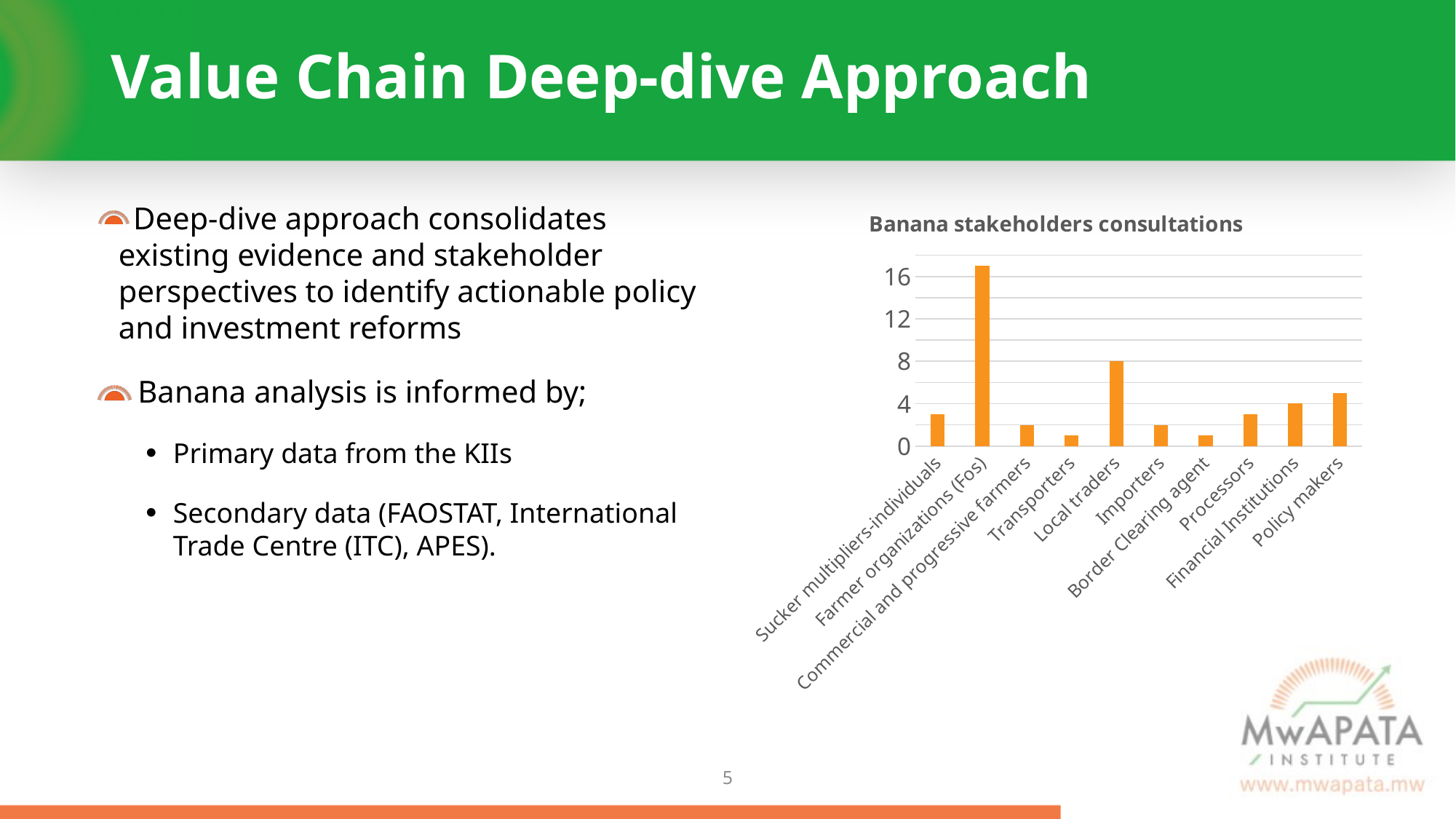
Is the value for Policy makers greater or less than 4? greater Which is larger, the value for Farmer organizations (Fos) or the value for Local traders? Farmer organizations (Fos) Is the value for Importers greater or less than 4? less Which stakeholder category has the highest number of consultations? Farmer organizations (Fos) How many stakeholder categories are shown in the chart? 10 What colour are the bars in the chart? orange Is the value for Local traders greater or less than 12? less What is the title of the chart? Banana stakeholders consultations Which is larger, the value for Local traders or the value for Policy makers? Local traders What kind of chart is shown on the slide? bar chart